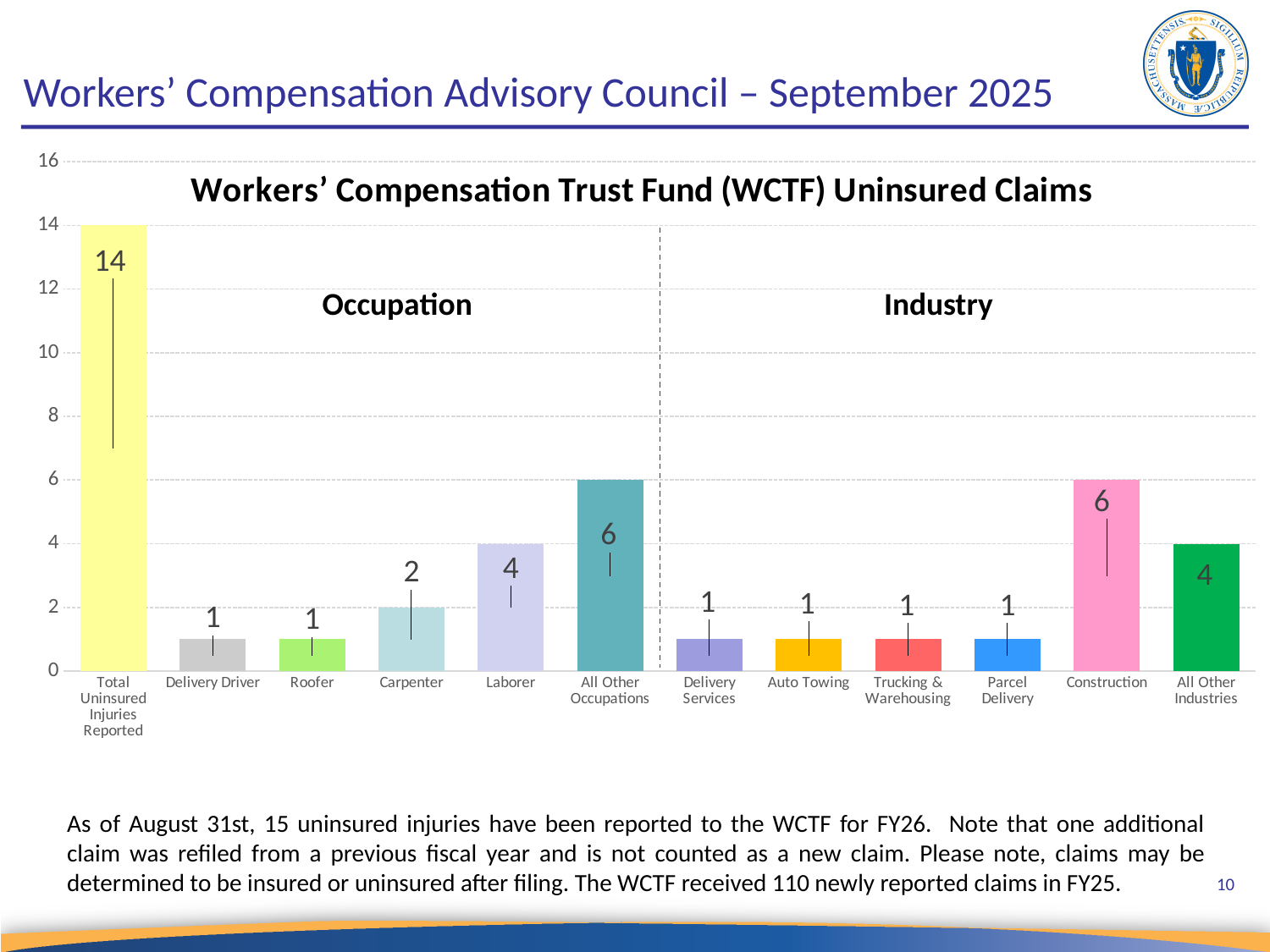
Is the value for Total Uninsured Injuries Reported greater or less than 10? greater How many categories are shown on the x axis? 12 What is the value for Carpenter? 2 What is the title of the chart? Workers' Compensation Trust Fund (WCTF) Uninsured Claims Which category has the highest value? Total Uninsured Injuries Reported What is the value for Laborer? 4 What is the difference between All Other Occupations and Laborer? 2 What kind of chart is this? bar chart Which occupation category, excluding the total, has the highest value? All Other Occupations What is the value for Total Uninsured Injuries Reported? 14 What is the value for Construction? 6 Which is larger, Construction or All Other Industries? Construction